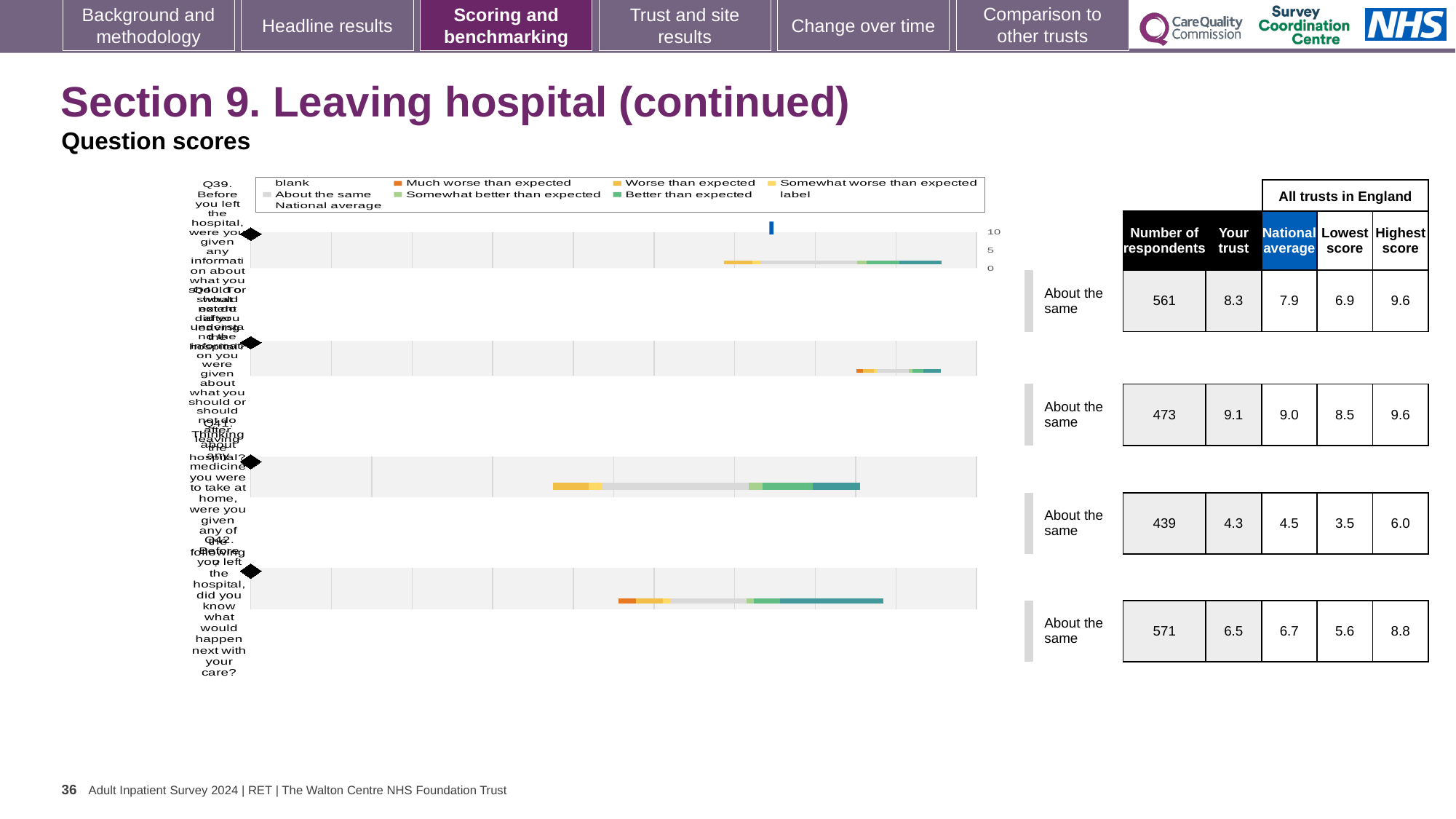
In the table beside the chart, what is the number of respondents in the row for Q42 (the last row)? 571 What kind of chart is shown on the slide? bar chart In the table beside the chart, what is the difference between the highest score (9.6) and the lowest score (6.9) in the first row? 2.7 In the table beside the chart, what is the national average in the row for Q42 (the last row)? 6.7 In the table beside the chart, is the 'Your trust' score in the first row (8.3) larger or smaller than the national average (7.9)? larger In the table beside the chart, which row has the lowest 'Your trust' score? the third row (4.3) What benchmark label is shown next to each bar in the chart? About the same In the table beside the chart, which row has the highest 'Your trust' score? the second row (9.1) What is the highest value shown on the chart's numeric axis? 10 How many questions (Q39 to Q42) are plotted as bars in the chart? 4 Which colour does the chart legend use for 'Much worse than expected'? orange In the table beside the chart, what is the 'Your trust' score in the row for Q39 (the first row)? 8.3